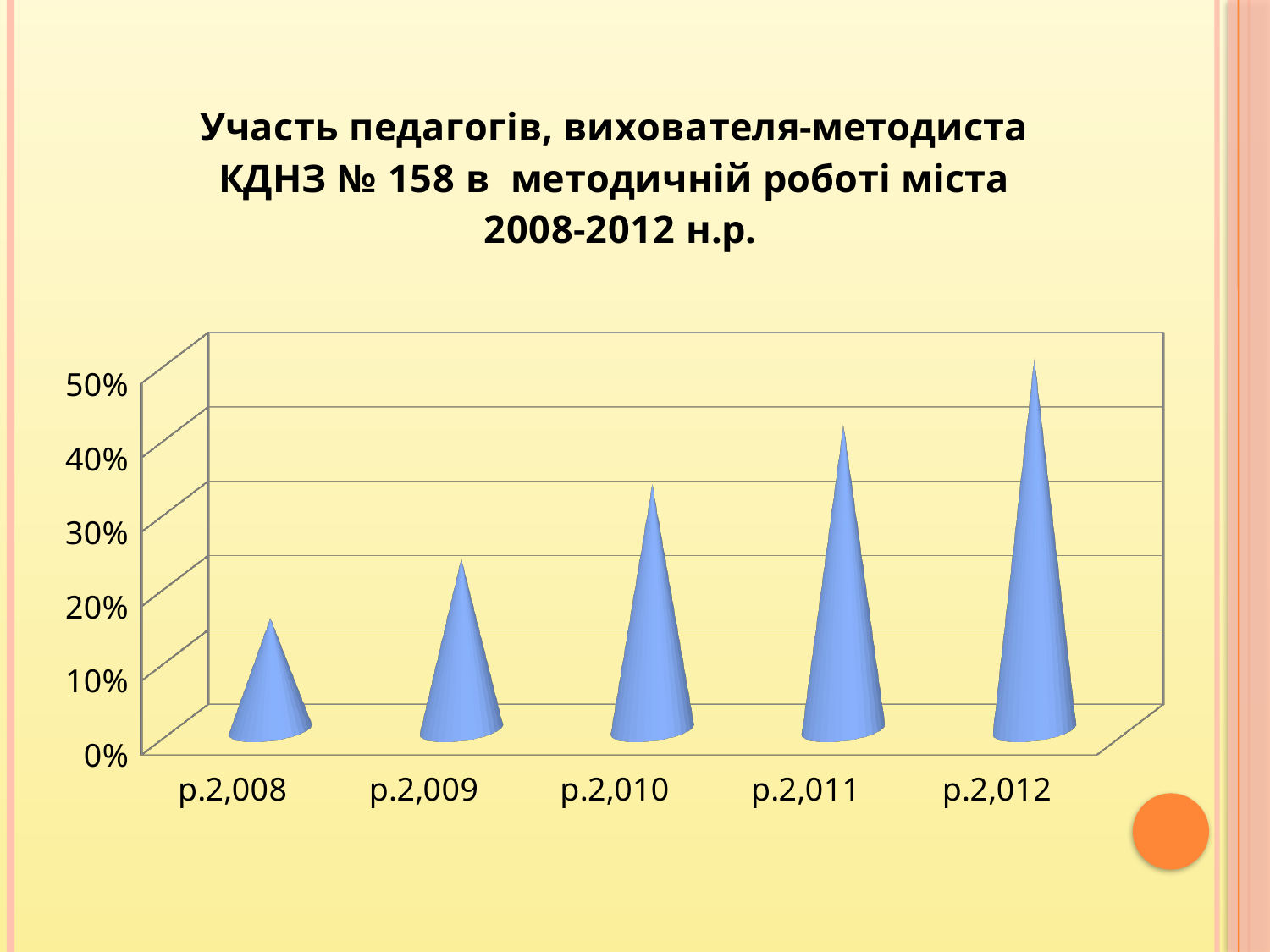
Which category has the highest value? р.2,012 Which is larger, the value for р.2,011 or the value for р.2,009? р.2,011 Which category has the lowest value? р.2,008 How many categories (years) are plotted on the chart? 5 What is the highest percentage label shown on the vertical axis? 50% Is the value for р.2,009 greater or less than 30%? less Is the value for р.2,011 greater or less than 50%? less Do the values rise or fall from р.2,008 to р.2,012? rise What kind of chart is shown on the slide? bar chart Is the value for р.2,010 greater or less than 20%? greater